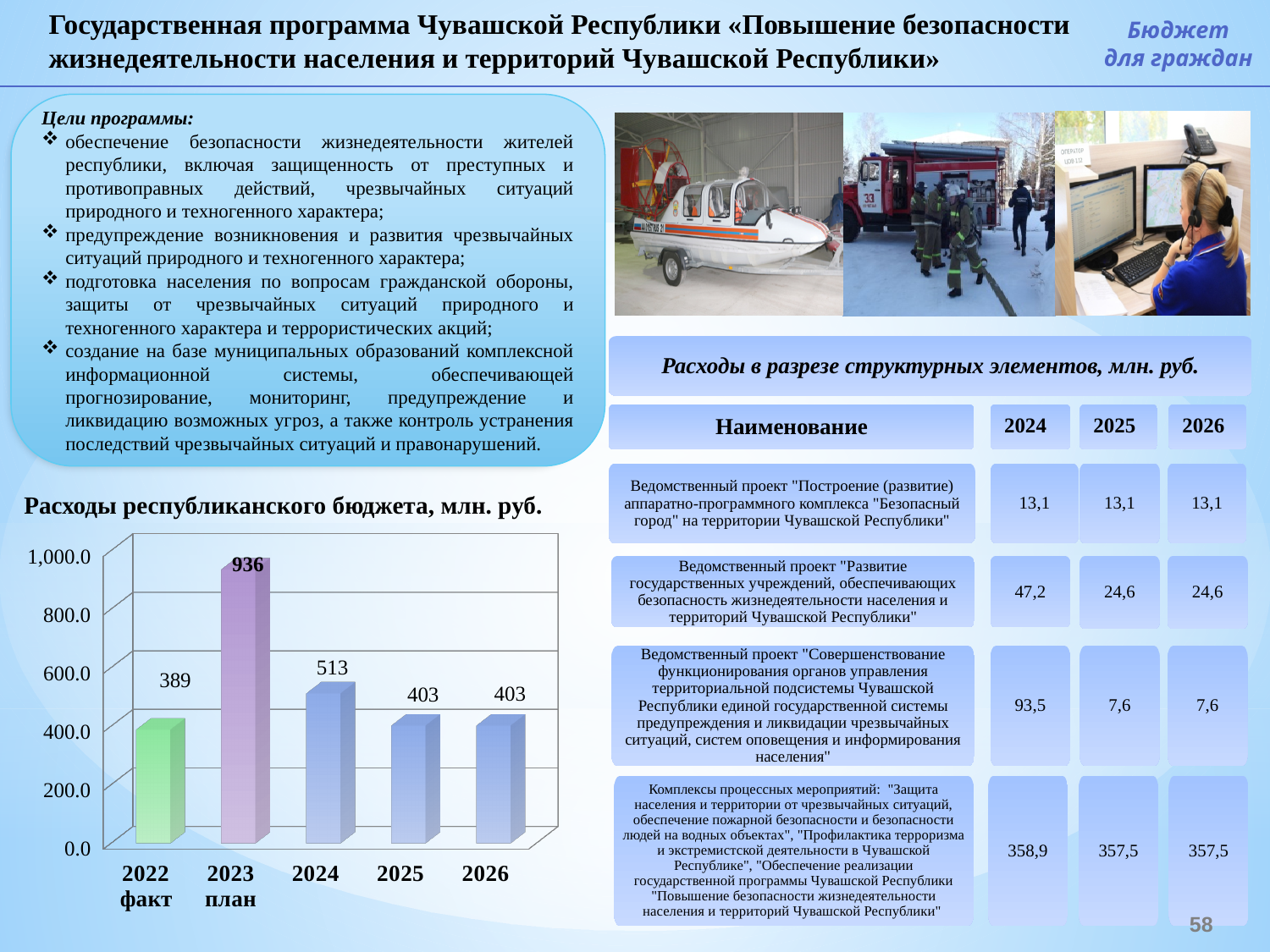
How many categories are shown on the x axis of the chart 'Расходы республиканского бюджета, млн. руб.'? 5 Is the value for 2023 план greater or less than 800.0 in the chart 'Расходы республиканского бюджета, млн. руб.'? greater Which category has the highest value in the chart 'Расходы республиканского бюджета, млн. руб.'? 2023 план What is the difference between the values for 2024 and 2025 in the chart 'Расходы республиканского бюджета, млн. руб.'? 110 What kind of chart is 'Расходы республиканского бюджета, млн. руб.'? bar chart Which category has the lowest value in the chart 'Расходы республиканского бюджета, млн. руб.'? 2022 факт What is the value for 2023 план in the chart 'Расходы республиканского бюджета, млн. руб.'? 936 What is the difference between the values for 2023 план and 2024 in the chart 'Расходы республиканского бюджета, млн. руб.'? 423 What is the value for 2022 факт in the chart 'Расходы республиканского бюджета, млн. руб.'? 389 Which is larger in the chart 'Расходы республиканского бюджета, млн. руб.': the value for 2022 факт or the value for 2024? 2024 What is the value for 2026 in the chart 'Расходы республиканского бюджета, млн. руб.'? 403 What is the value for 2024 in the chart 'Расходы республиканского бюджета, млн. руб.'? 513